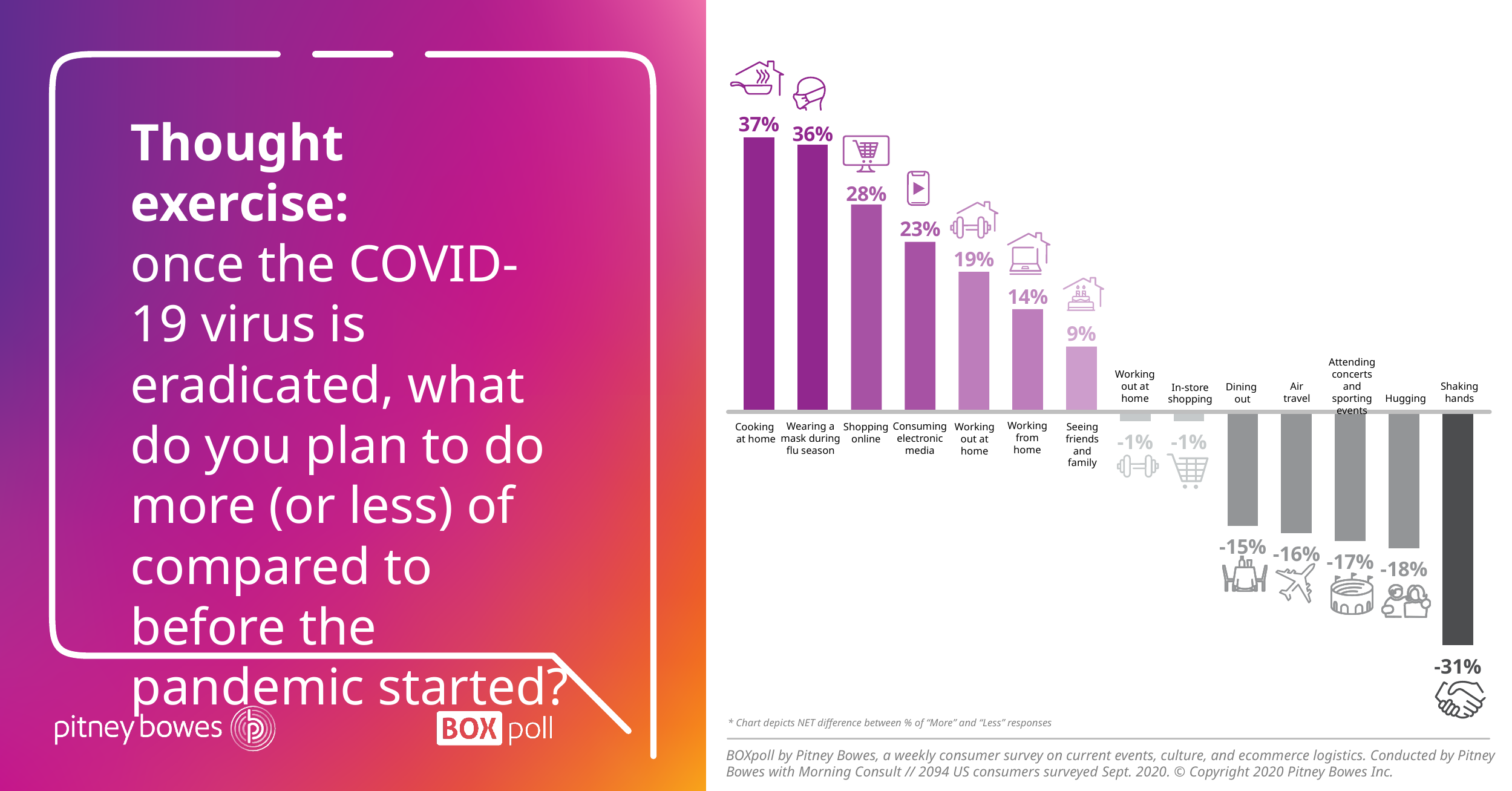
What is the difference between the values for Cooking at home and Wearing a mask during flu season? 1% What is the value for Shaking hands? -31% How many categories are shown in the chart? 14 What is the value for Cooking at home? 37% What kind of chart is shown on the slide? Bar chart Which is larger, the value for Consuming electronic media or the value for Working from home? Consuming electronic media Which category has the lowest value? Shaking hands Do the values rise or fall from left to right across the chart? Fall What is the value for Air travel? -16% Which category has the highest value? Cooking at home What is the value for Hugging? -18% What is the value for Shopping online? 28%